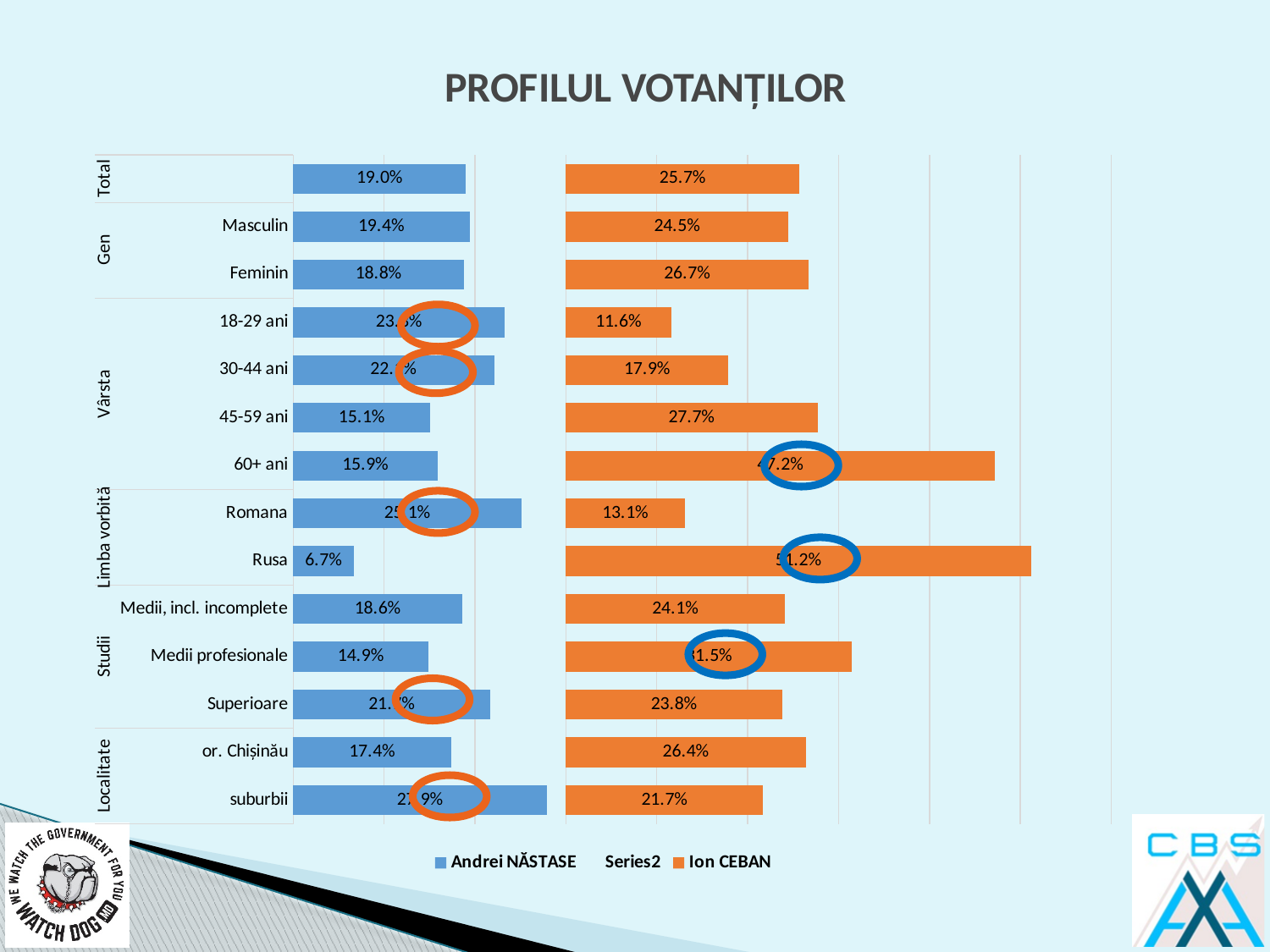
In the Masculin category, who has the larger value, Andrei NĂSTASE or Ion CEBAN? Ion CEBAN What is the value for Ion CEBAN in the 45-59 ani category? 27.7% In which category does Ion CEBAN have the highest value? Rusa What is the value for Andrei NĂSTASE in the Total category? 19.0% What is the value for Andrei NĂSTASE in the Rusa category? 6.7% How many categories are plotted on the chart? 14 How many entries does the legend list? 3 In the Total category, what is the difference between Ion CEBAN's value and Andrei NĂSTASE's value? 6.7 percentage points In which category does Ion CEBAN have the lowest value? 18-29 ani What kind of chart is shown on the slide? Bar chart What is the value for Ion CEBAN in the Feminin category? 26.7% In which category does Andrei NĂSTASE have the lowest value? Rusa